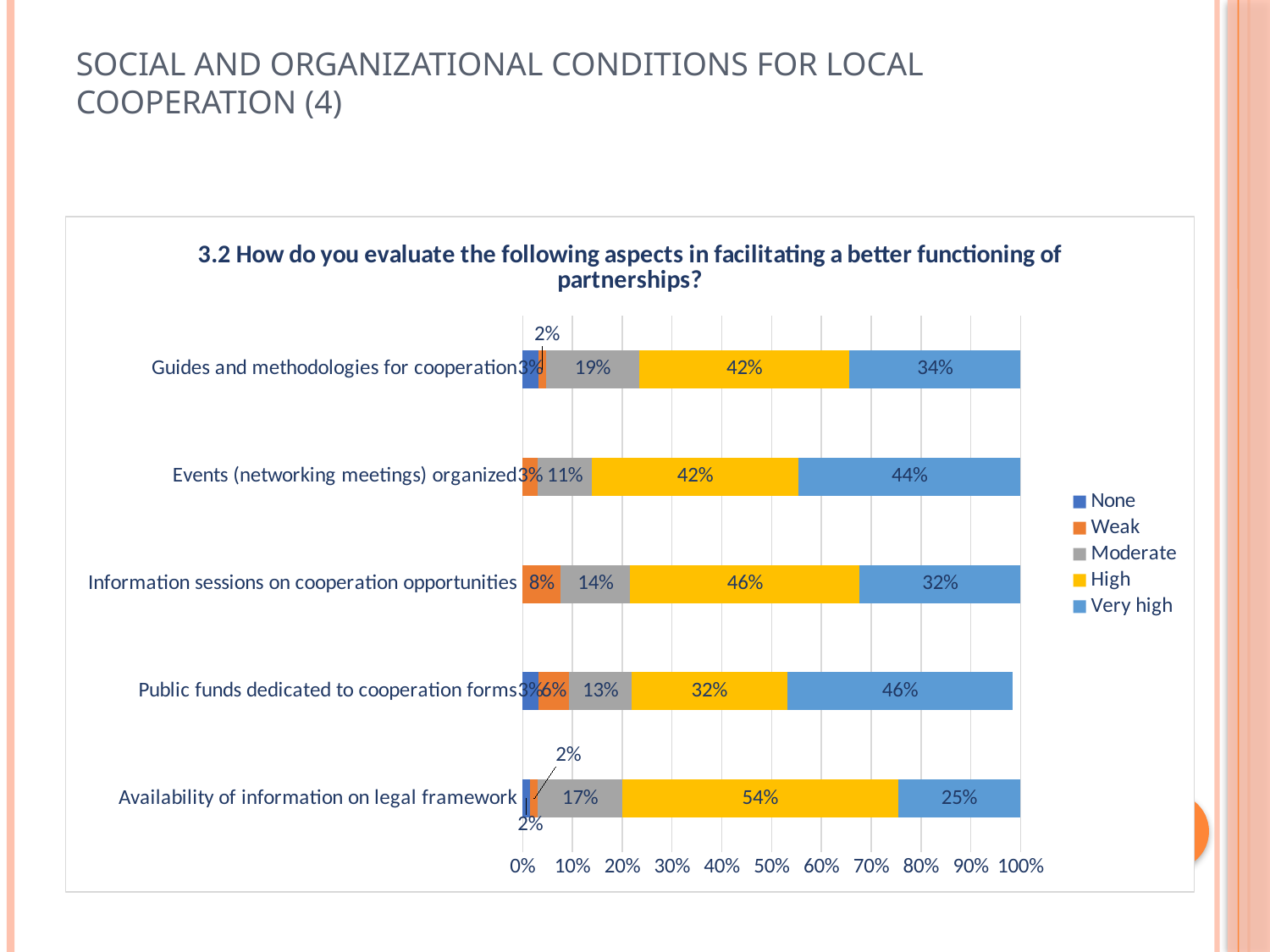
What is the 'Moderate' value for 'Guides and methodologies for cooperation'? 19% What is the 'High' value for 'Availability of information on legal framework'? 54% What is the 'Weak' value for 'Information sessions on cooperation opportunities'? 8% Which category has the highest 'Very high' value? Public funds dedicated to cooperation forms What is the 'Very high' value for 'Public funds dedicated to cooperation forms'? 46% How many categories (aspects) are plotted in the chart? 5 Which category has the lowest 'Very high' value? Availability of information on legal framework What is the difference between the 'High' values for 'Availability of information on legal framework' and 'Public funds dedicated to cooperation forms'? 22% How many series does the legend list? 5 Which is larger: the 'Very high' value for 'Events (networking meetings) organized' or for 'Guides and methodologies for cooperation'? Events (networking meetings) organized What kind of chart is shown on the slide? Stacked bar chart Which series is shown in yellow in the legend? High